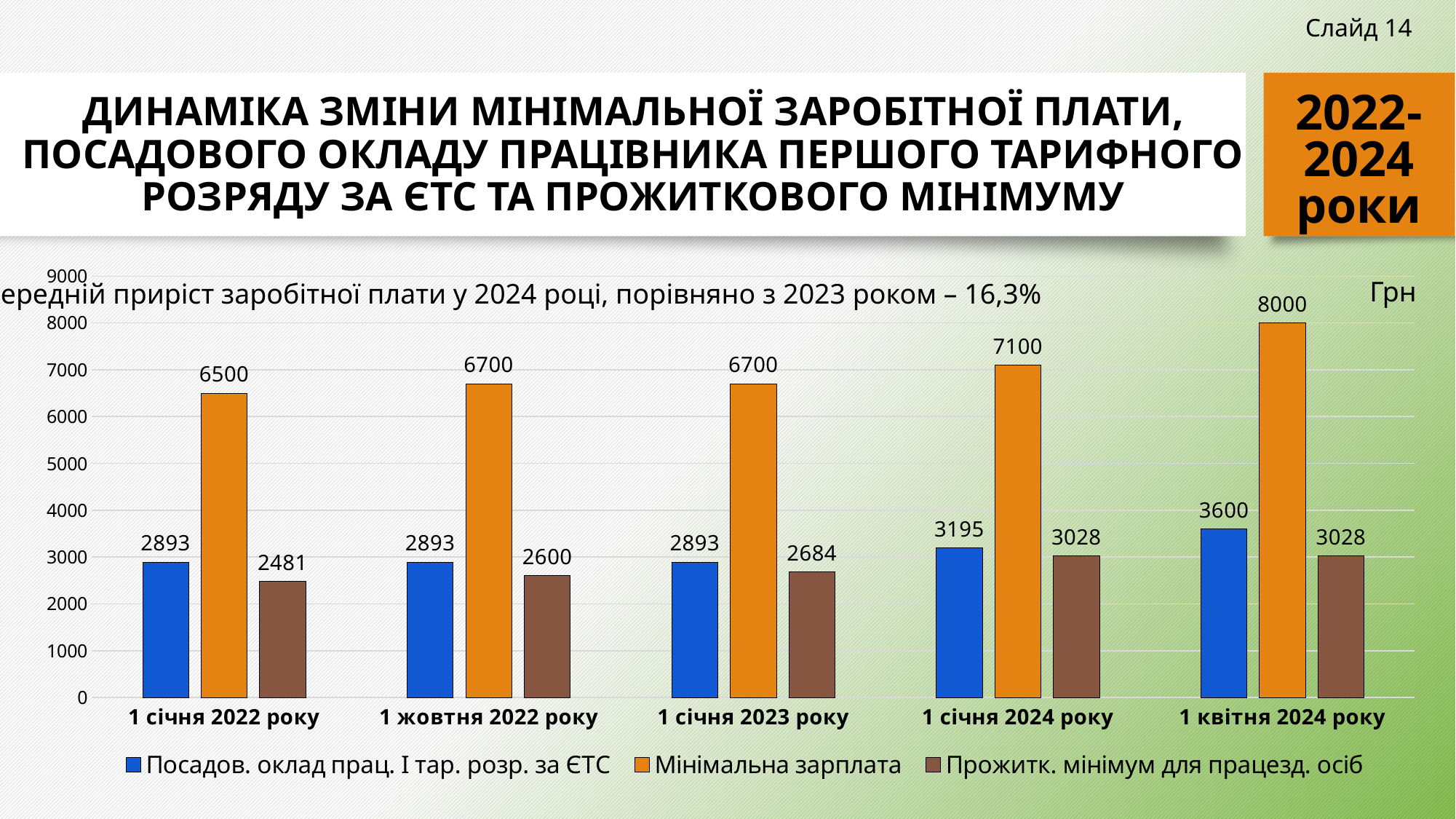
How many categories are shown on the x axis? 5 What colour are the bars for Мінімальна зарплата? Orange For which category is Мінімальна зарплата highest? 1 квітня 2024 року What is the value of Прожитк. мінімум для працезд. осіб for 1 жовтня 2022 року? 2600 How many series does the legend list? 3 What is the value of Мінімальна зарплата for 1 квітня 2024 року? 8000 What kind of chart is shown on the slide? Bar chart Does Мінімальна зарплата rise or fall from 1 січня 2022 року to 1 квітня 2024 року? Rise Which is larger on 1 січня 2023 року: Посадов. оклад прац. І тар. розр. за ЄТС or Прожитк. мінімум для працезд. осіб? Посадов. оклад прац. І тар. розр. за ЄТС For which category is Прожитк. мінімум для працезд. осіб lowest? 1 січня 2022 року What is the difference between Мінімальна зарплата on 1 квітня 2024 року and on 1 січня 2024 року? 900 What is the value of Посадов. оклад прац. І тар. розр. за ЄТС for 1 січня 2024 року? 3195